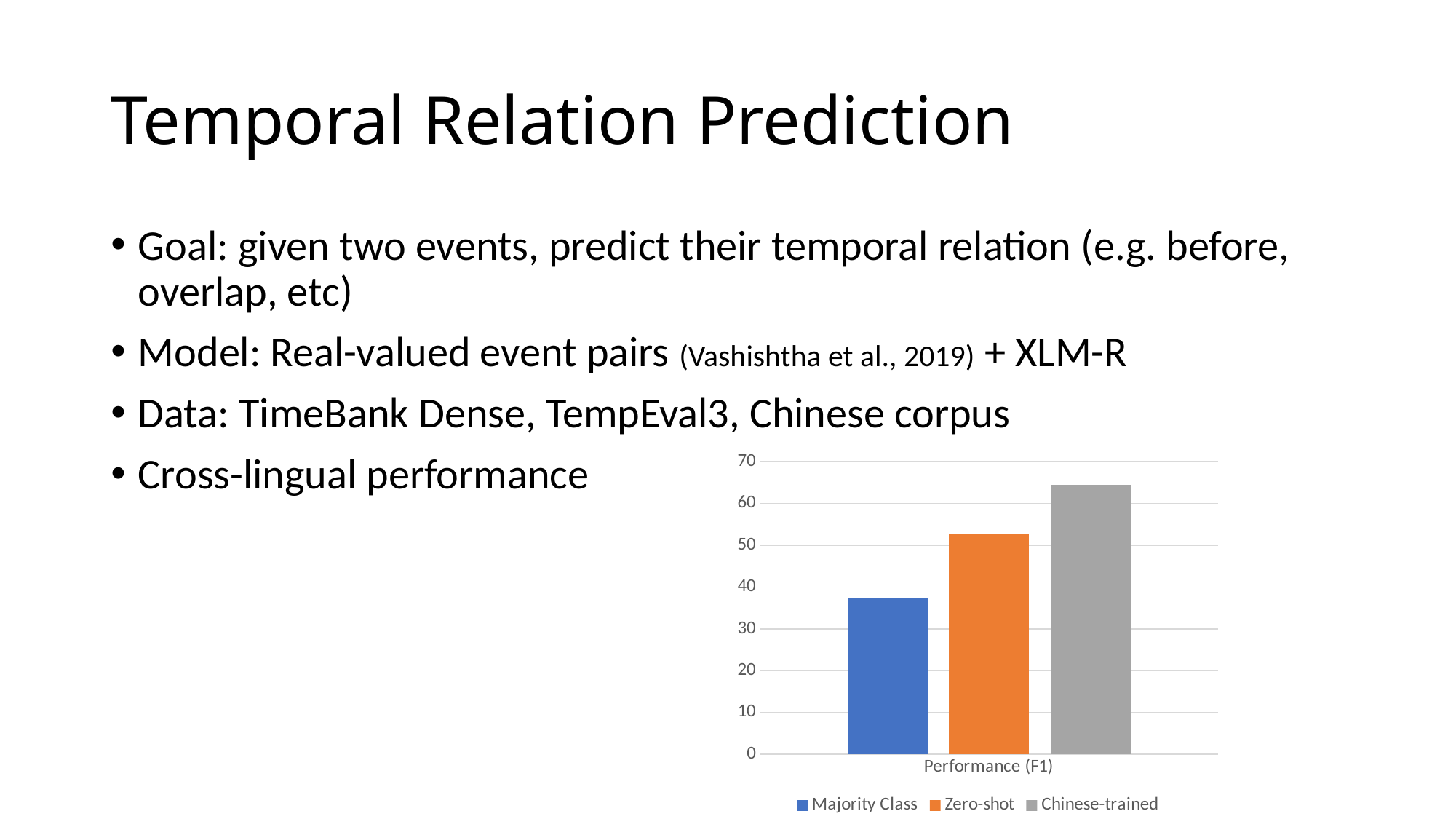
How many categories are shown on the x axis of the chart? 1 Which is larger, the value for Chinese-trained or the value for Zero-shot? Chinese-trained What is the category label shown on the x axis of the chart? Performance (F1) What kind of chart is shown on the slide? bar chart What colour is the bar for the Zero-shot series? orange Which series has the lowest value in the chart? Majority Class Which is larger, the value for Zero-shot or the value for Majority Class? Zero-shot Is the value for Majority Class greater or less than 40? less Is the value for Chinese-trained greater or less than 60? greater How many series does the chart's legend list? 3 Is the value for Zero-shot greater or less than 50? greater Which series has the highest value in the chart? Chinese-trained